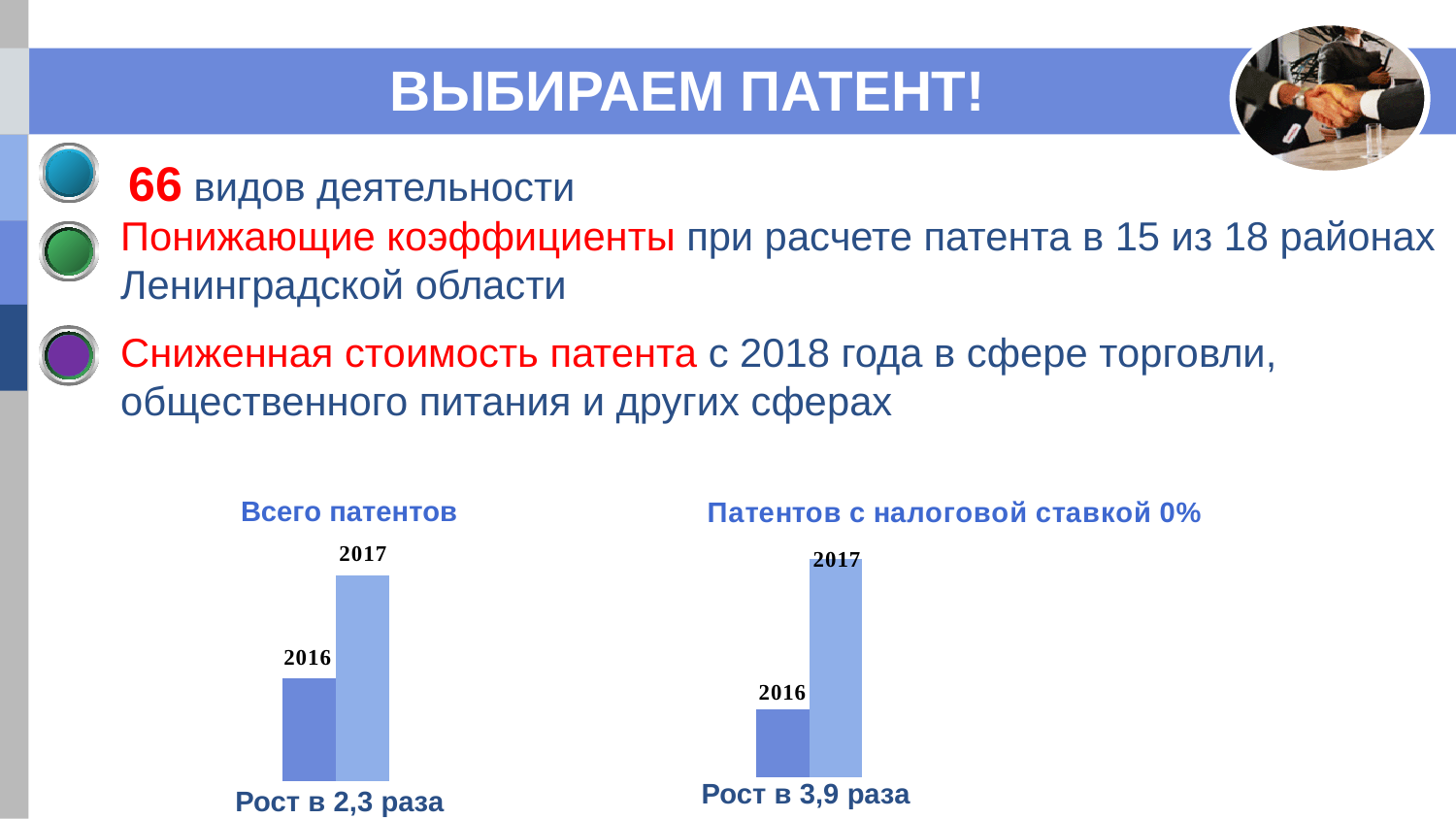
In the 'Всего патентов' chart, which year has the taller bar? 2017 In the 'Патентов с налоговой ставкой 0%' chart, which year has the taller bar? 2017 What is the title of the chart on the left of the slide? Всего патентов In the 'Патентов с налоговой ставкой 0%' chart, how many bars are plotted? 2 What kind of chart is the 'Патентов с налоговой ставкой 0%' chart? bar chart In the 'Всего патентов' chart, how many bars are plotted? 2 In the 'Всего патентов' chart, which year has the shorter bar? 2016 In the 'Патентов с налоговой ставкой 0%' chart, which year has the shorter bar? 2016 What kind of chart is the 'Всего патентов' chart? bar chart What growth factor is stated below the 'Патентов с налоговой ставкой 0%' chart? Рост в 3,9 раза In the 'Всего патентов' chart, is the bar for 2017 taller or shorter than the bar for 2016? taller In the 'Патентов с налоговой ставкой 0%' chart, do the values rise or fall from 2016 to 2017? rise